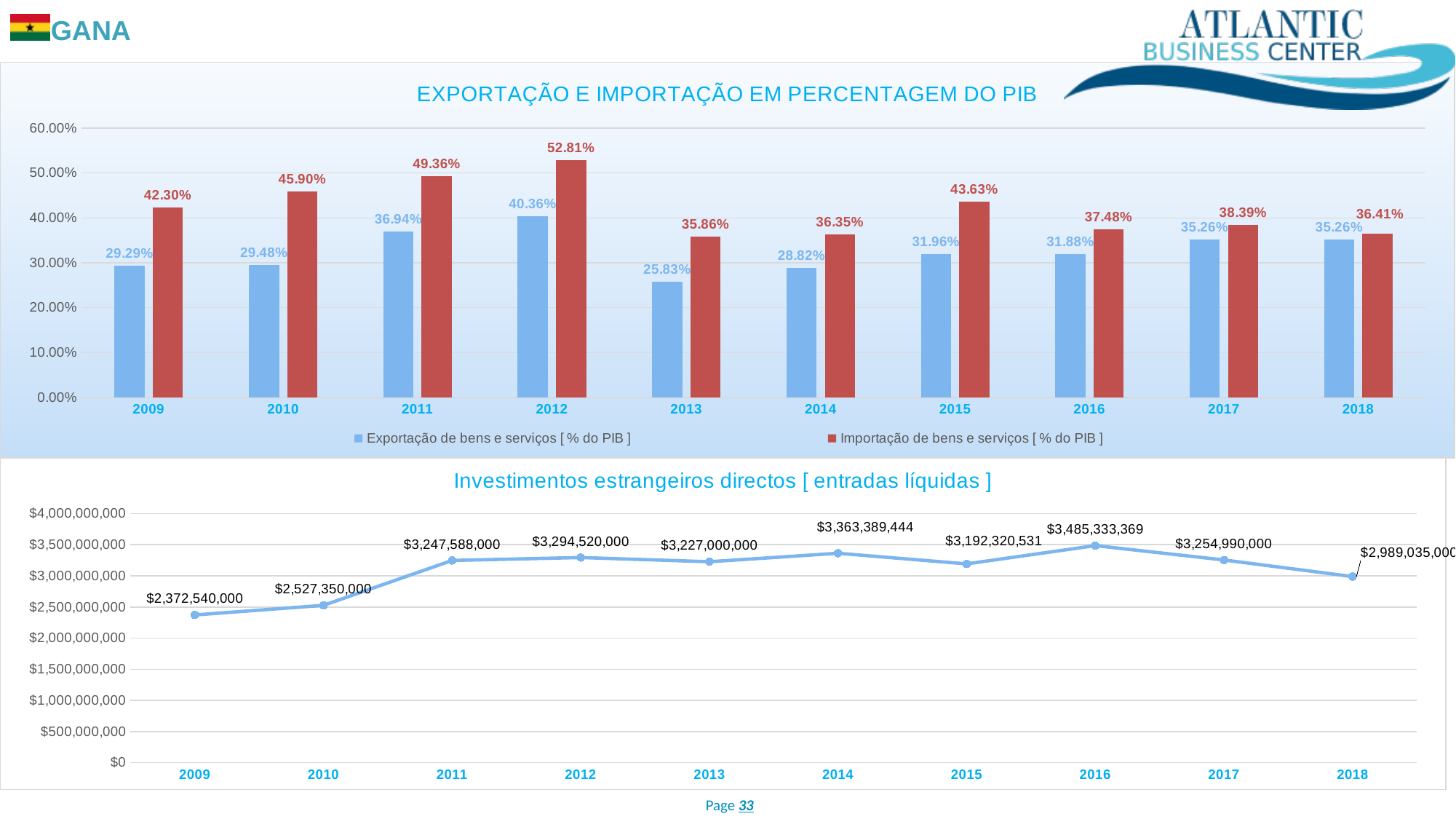
In the 'EXPORTAÇÃO E IMPORTAÇÃO EM PERCENTAGEM DO PIB' chart, what is the value of Exportação de bens e serviços in 2013? 25.83% In the 'Investimentos estrangeiros directos [ entradas líquidas ]' chart, what is the value for 2016? $3,485,333,369 In the 'EXPORTAÇÃO E IMPORTAÇÃO EM PERCENTAGEM DO PIB' chart, what is the value of Importação de bens e serviços in 2012? 52.81% In the 'Investimentos estrangeiros directos [ entradas líquidas ]' chart, which year has the lowest value? 2009 In the 'Investimentos estrangeiros directos [ entradas líquidas ]' chart, how many years are plotted? 10 In the 'EXPORTAÇÃO E IMPORTAÇÃO EM PERCENTAGEM DO PIB' chart, which year has the lowest Exportação de bens e serviços value? 2013 In the 'EXPORTAÇÃO E IMPORTAÇÃO EM PERCENTAGEM DO PIB' chart, how many series does the legend list? 2 In the 'EXPORTAÇÃO E IMPORTAÇÃO EM PERCENTAGEM DO PIB' chart, what is the difference between Importação and Exportação in 2011? 12.42% What type of chart is the 'EXPORTAÇÃO E IMPORTAÇÃO EM PERCENTAGEM DO PIB' chart? Bar chart In the 'EXPORTAÇÃO E IMPORTAÇÃO EM PERCENTAGEM DO PIB' chart, which year has the highest Importação de bens e serviços value? 2012 What type of chart is the 'Investimentos estrangeiros directos [ entradas líquidas ]' chart? Line chart In the 'Investimentos estrangeiros directos [ entradas líquidas ]' chart, is the value for 2017 larger or smaller than the value for 2018? Larger